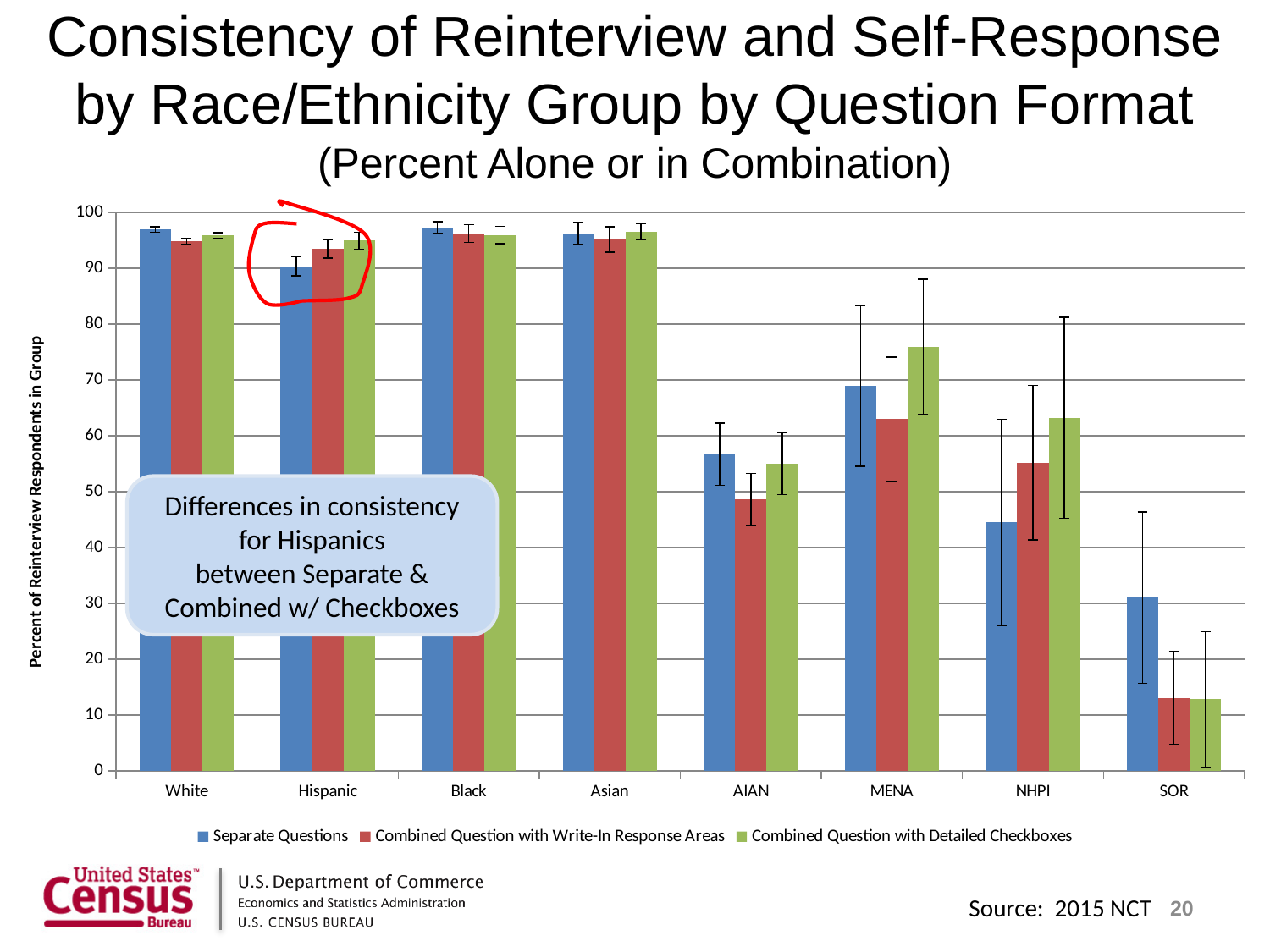
What type of chart is shown on the slide? Bar chart How many race/ethnicity groups are shown on the x axis of the chart? 8 For MENA, which series has the highest value? Combined Question with Detailed Checkboxes Is the Combined Question with Detailed Checkboxes value for MENA greater or less than 70? greater Is the Separate Questions value for SOR greater or less than 40? less Is the Separate Questions value for NHPI greater or less than 50? less What is the title of the chart's y axis? Percent of Reinterview Respondents in Group Which race/ethnicity group has the lowest Separate Questions value? SOR How many series does the chart's legend list? 3 For NHPI, which is larger: the Separate Questions value or the Combined Question with Detailed Checkboxes value? Combined Question with Detailed Checkboxes For Hispanic, which is larger: the Separate Questions value or the Combined Question with Detailed Checkboxes value? Combined Question with Detailed Checkboxes